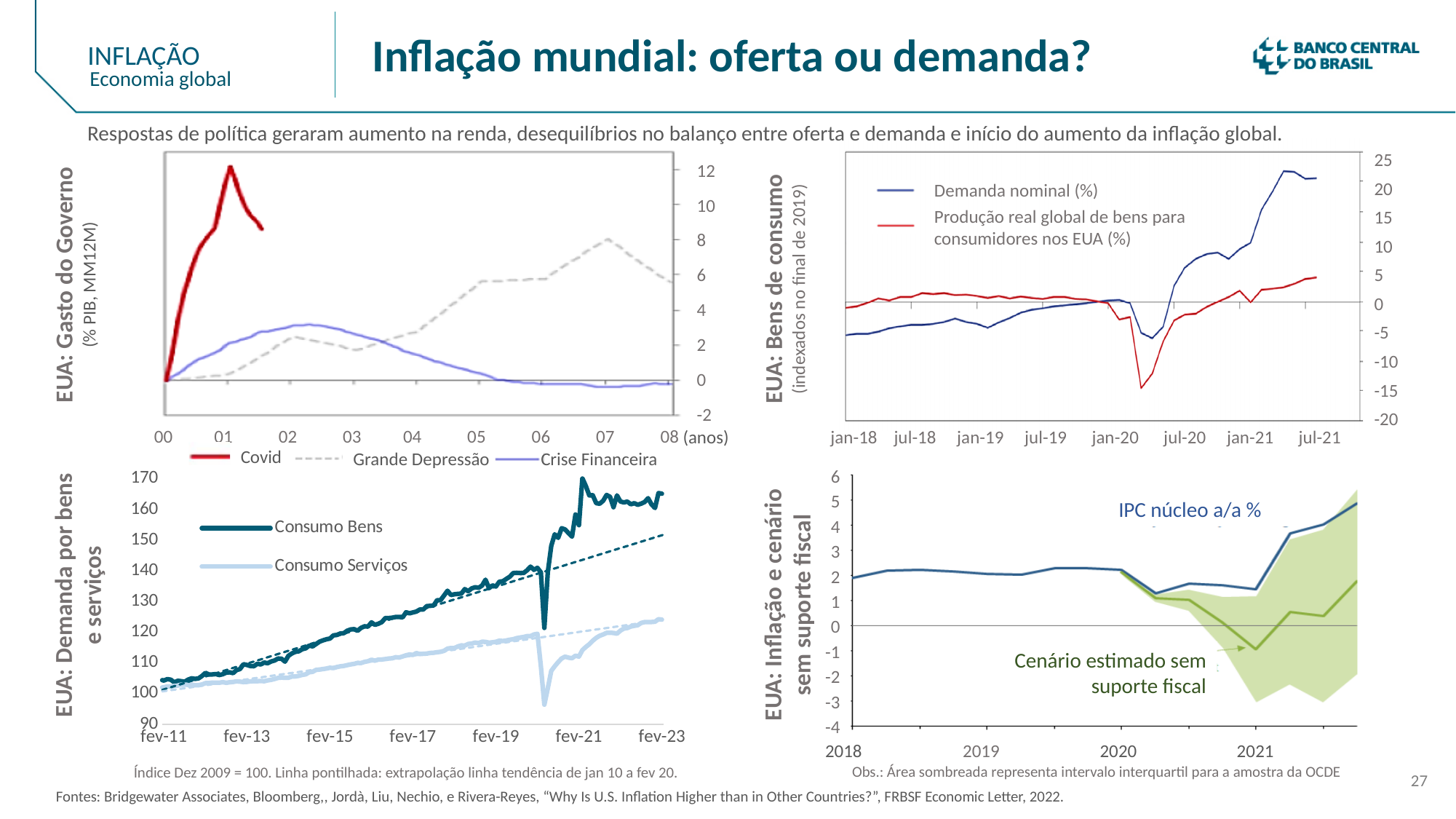
What kind of chart is the 'EUA: Gasto do Governo' chart at the top left? line chart In the 'EUA: Inflação e cenário sem suporte fiscal' chart at the bottom right, is the lowest value of the 'Cenário estimado sem suporte fiscal' line greater or less than 0? less In the 'EUA: Demanda por bens e serviços' chart at the bottom left, which series is higher at fev-23: Consumo Bens or Consumo Serviços? Consumo Bens In the 'EUA: Demanda por bens e serviços' chart, is the value of Consumo Bens at fev-23 greater or less than 160? greater How many series does the legend of the 'EUA: Gasto do Governo' chart list? 3 In the 'EUA: Gasto do Governo' chart, which series reaches a higher peak: Covid or Grande Depressão? Covid In the 'EUA: Bens de consumo' chart, is the lowest value of the Produção real global de bens series greater or less than -10? less How many series does the legend of the 'EUA: Bens de consumo' chart at the top right list? 2 In the 'EUA: Demanda por bens e serviços' chart, does the Consumo Bens series overall rise or fall from fev-11 to fev-23? rise